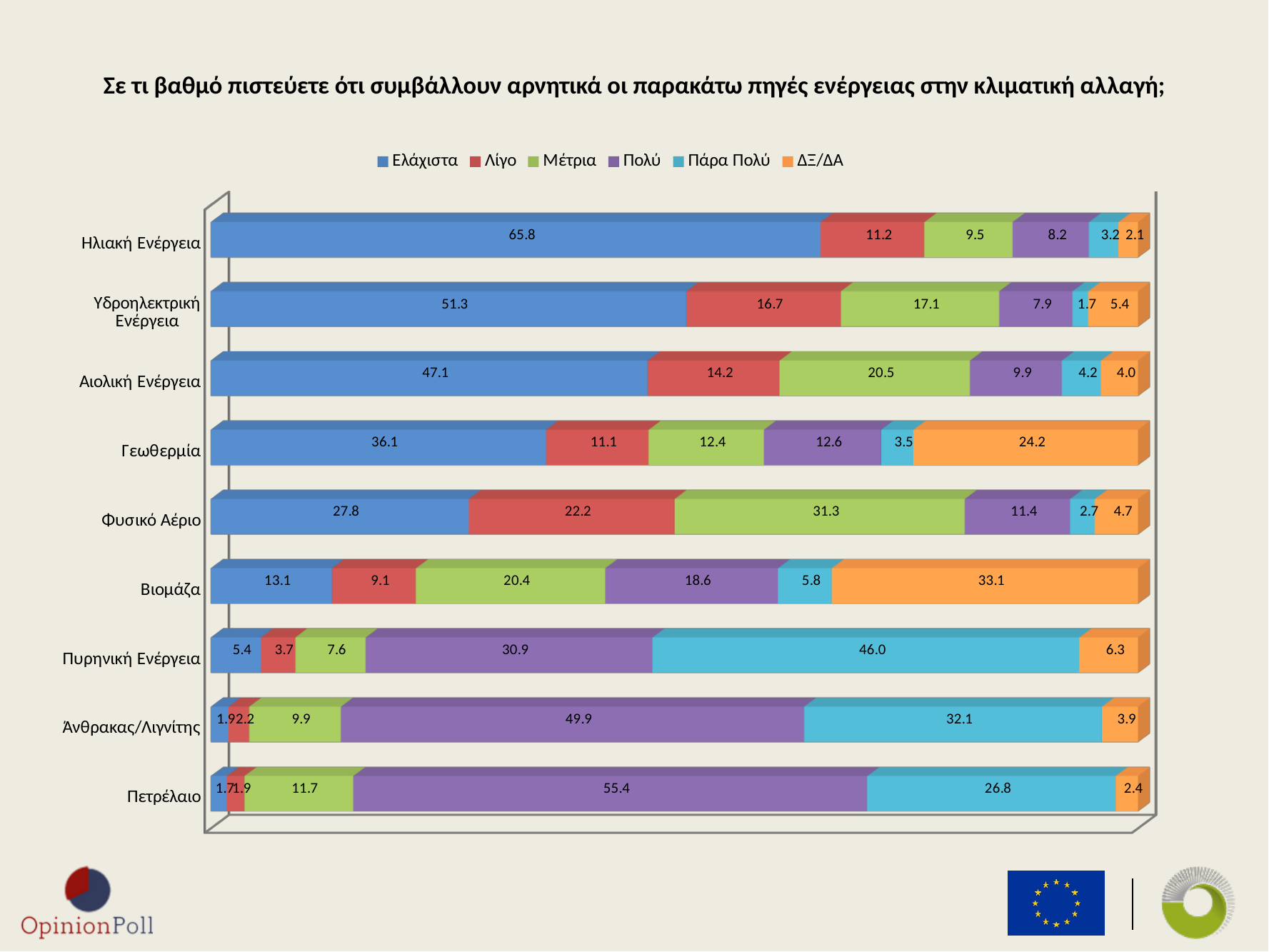
What is the value for ΔΞ/ΔΑ for Γεωθερμία? 24.2 What is the difference between the Πάρα Πολύ values for Πυρηνική Ενέργεια and Άνθρακας/Λιγνίτης? 13.9 What is the value for Μέτρια for Φυσικό Αέριο? 31.3 What kind of chart is shown on the slide? Stacked bar chart What is the value for Πάρα Πολύ for Πυρηνική Ενέργεια? 46.0 Which energy source has the lowest value for Ελάχιστα? Πετρέλαιο Which energy source has the highest value for Ελάχιστα? Ηλιακή Ενέργεια Which has the larger Πολύ value, Πετρέλαιο or Άνθρακας/Λιγνίτης? Πετρέλαιο Which energy source has the highest value for ΔΞ/ΔΑ? Βιομάζα What is the value for Ελάχιστα for Ηλιακή Ενέργεια? 65.8 How many energy sources are shown on the chart? 9 How many series does the legend list? 6